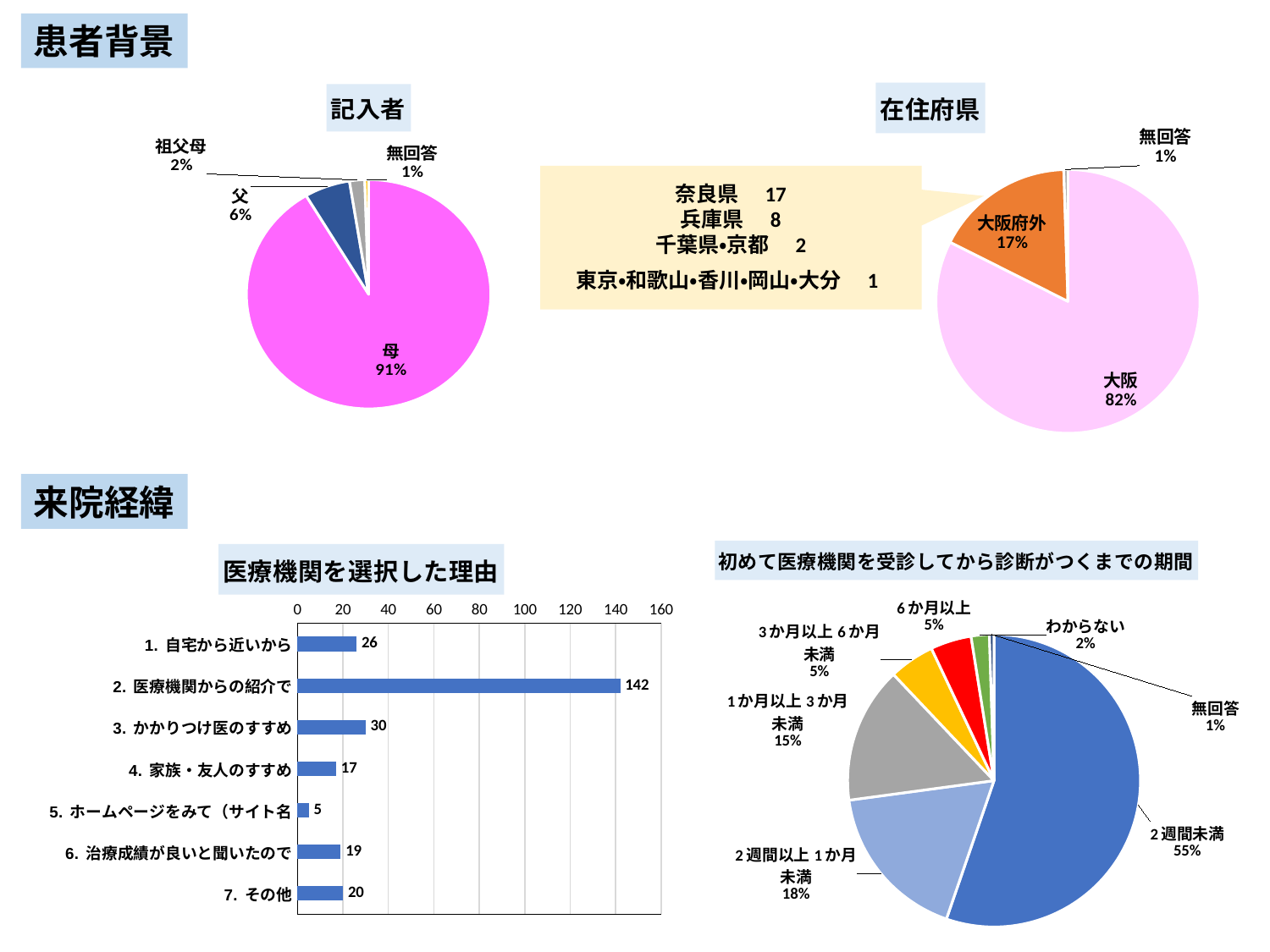
In the 記入者 pie chart, how many slices are there? 4 In the 初めて医療機関を受診してから診断がつくまでの期間 pie chart, what share does 1か月以上3か月未満 have? 15% What kind of chart is 医療機関を選択した理由? Bar chart In the 在住府県 pie chart, what share does 大阪府外 have? 17% In the 記入者 pie chart, what share does 父 have? 6% In the 医療機関を選択した理由 chart, what is the difference between 3. かかりつけ医のすすめ and 1. 自宅から近いから? 4 In the 在住府県 pie chart, which category has the largest share? 大阪 In the 医療機関を選択した理由 chart, which category has the lowest value? 5. ホームページをみて（サイト名 In the 医療機関を選択した理由 chart, which is larger: 7. その他 or 6. 治療成績が良いと聞いたので? 7. その他 In the 医療機関を選択した理由 chart, what is the value for 2. 医療機関からの紹介で? 142